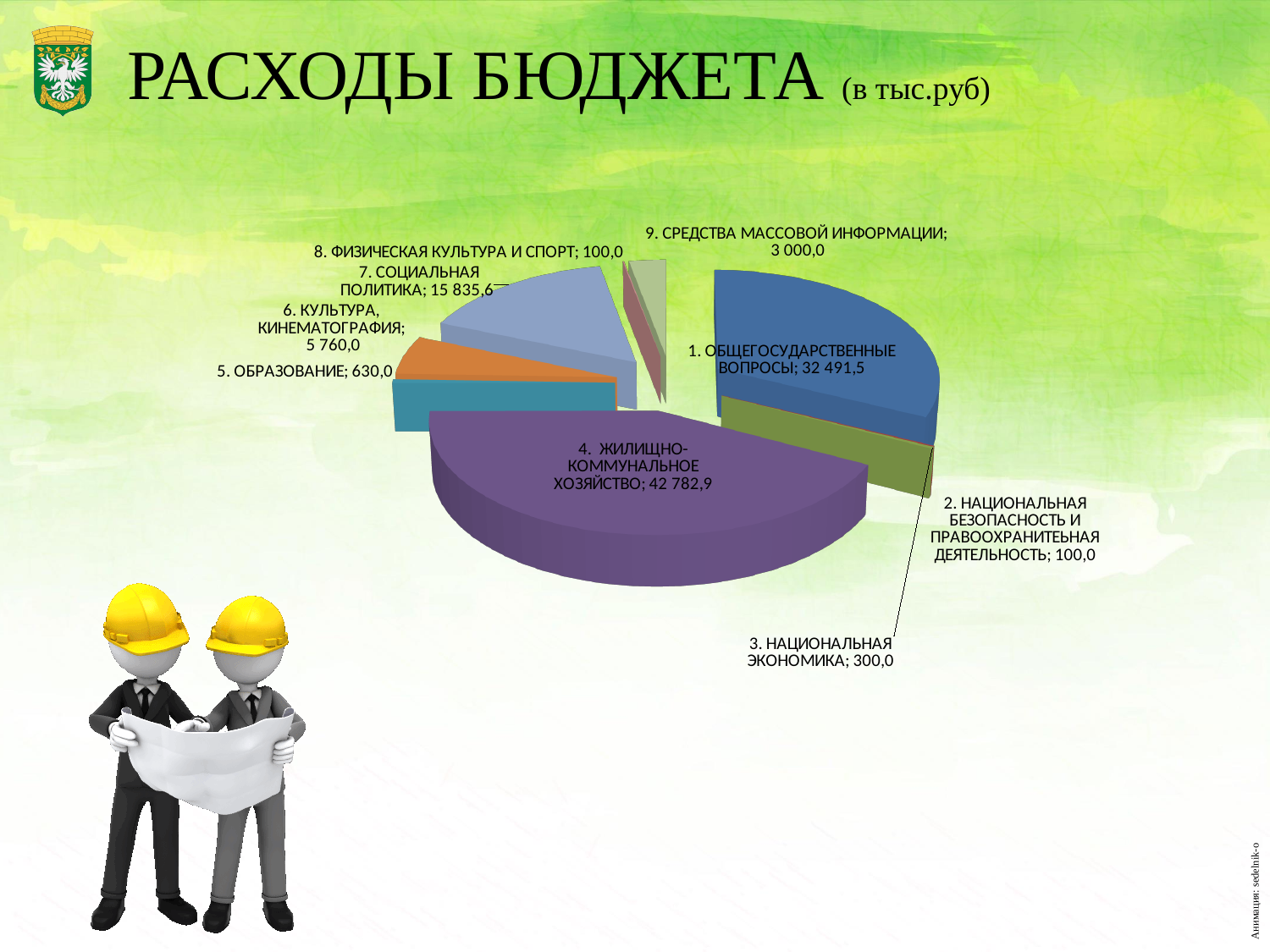
What kind of chart is shown on the slide? Pie chart What is the value for 4. ЖИЛИЩНО-КОММУНАЛЬНОЕ ХОЗЯЙСТВО? 42 782,9 Which is larger: the value for 6. КУЛЬТУРА, КИНЕМАТОГРАФИЯ or for 9. СРЕДСТВА МАССОВОЙ ИНФОРМАЦИИ? 6. КУЛЬТУРА, КИНЕМАТОГРАФИЯ In what units are the values on the chart expressed, according to the slide title? тыс.руб What is the value for 9. СРЕДСТВА МАССОВОЙ ИНФОРМАЦИИ? 3 000,0 What is the value for 7. СОЦИАЛЬНАЯ ПОЛИТИКА? 15 835,6 What is the difference between the values for 4. ЖИЛИЩНО-КОММУНАЛЬНОЕ ХОЗЯЙСТВО and 1. ОБЩЕГОСУДАРСТВЕННЫЕ ВОПРОСЫ? 10 291,4 What is the value for 5. ОБРАЗОВАНИЕ? 630,0 Which category has the largest value in the pie chart? 4. ЖИЛИЩНО-КОММУНАЛЬНОЕ ХОЗЯЙСТВО How many categories (slices) does the pie chart have? 9 What is the difference between the values for 6. КУЛЬТУРА, КИНЕМАТОГРАФИЯ and 9. СРЕДСТВА МАССОВОЙ ИНФОРМАЦИИ? 2 760,0 What is the value for 1. ОБЩЕГОСУДАРСТВЕННЫЕ ВОПРОСЫ? 32 491,5